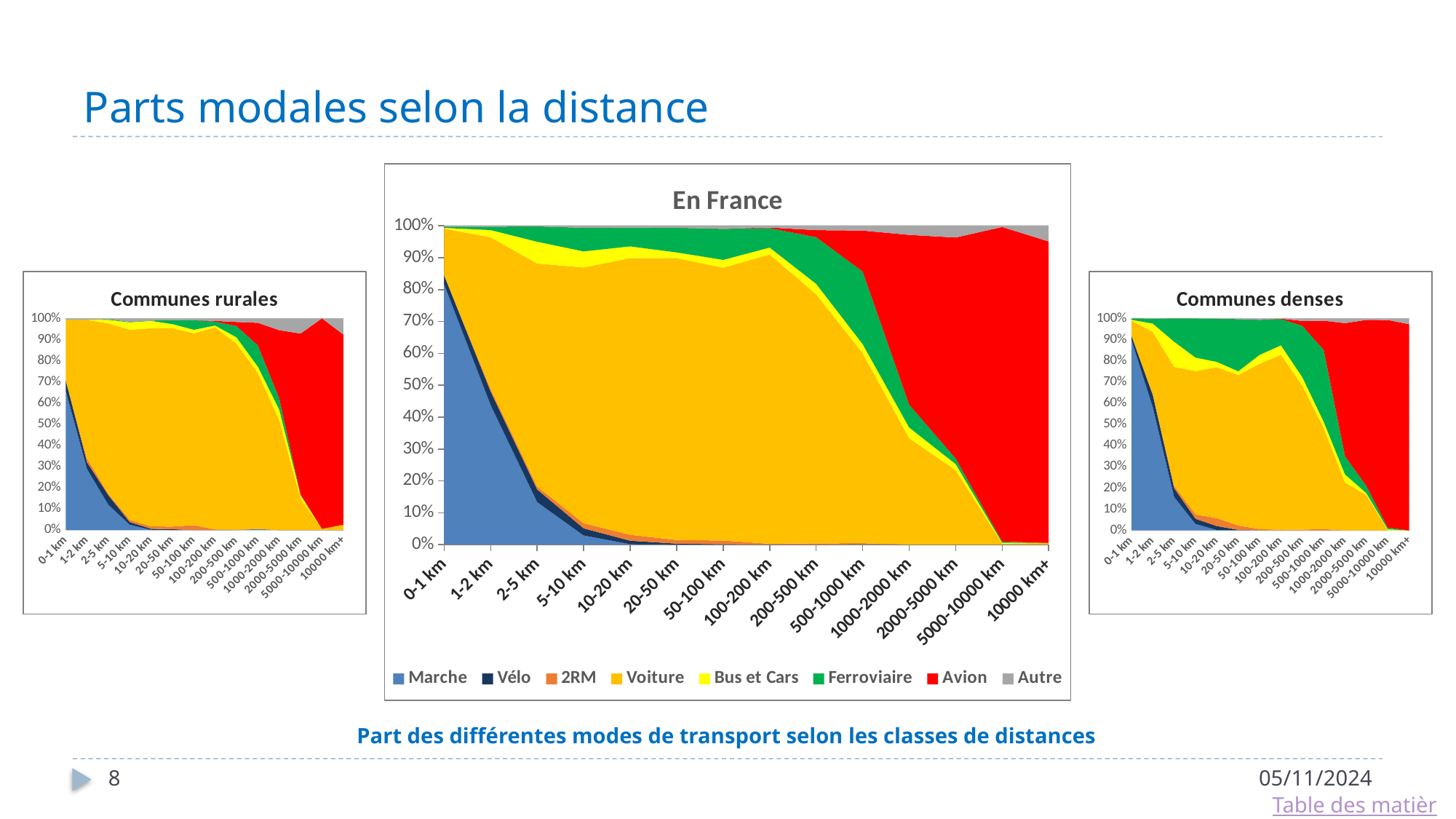
In the "Communes denses" chart, is the share of Marche for 0-1 km greater or less than 80%? greater How many distance classes are shown on the x axis of the "En France" chart? 14 What kind of chart is the "En France" chart? stacked area chart How many series does the legend of the "En France" chart list? 8 In the "En France" chart, which is larger for 0-1 km: the share of Marche or the share of Voiture? Marche In the "Communes rurales" chart, is the share of Marche for 0-1 km greater or less than 60%? greater What is the title of the chart in the centre of the slide? En France In the "En France" chart, is the share of Marche for 0-1 km greater or less than 80%? greater In the "En France" chart, does the share of Marche rise or fall as distance increases along the x axis? fall In the "En France" chart, which is larger for 10000 km+: the share of Avion or the share of Voiture? Avion In the "En France" chart, which colour represents Avion in the legend? red